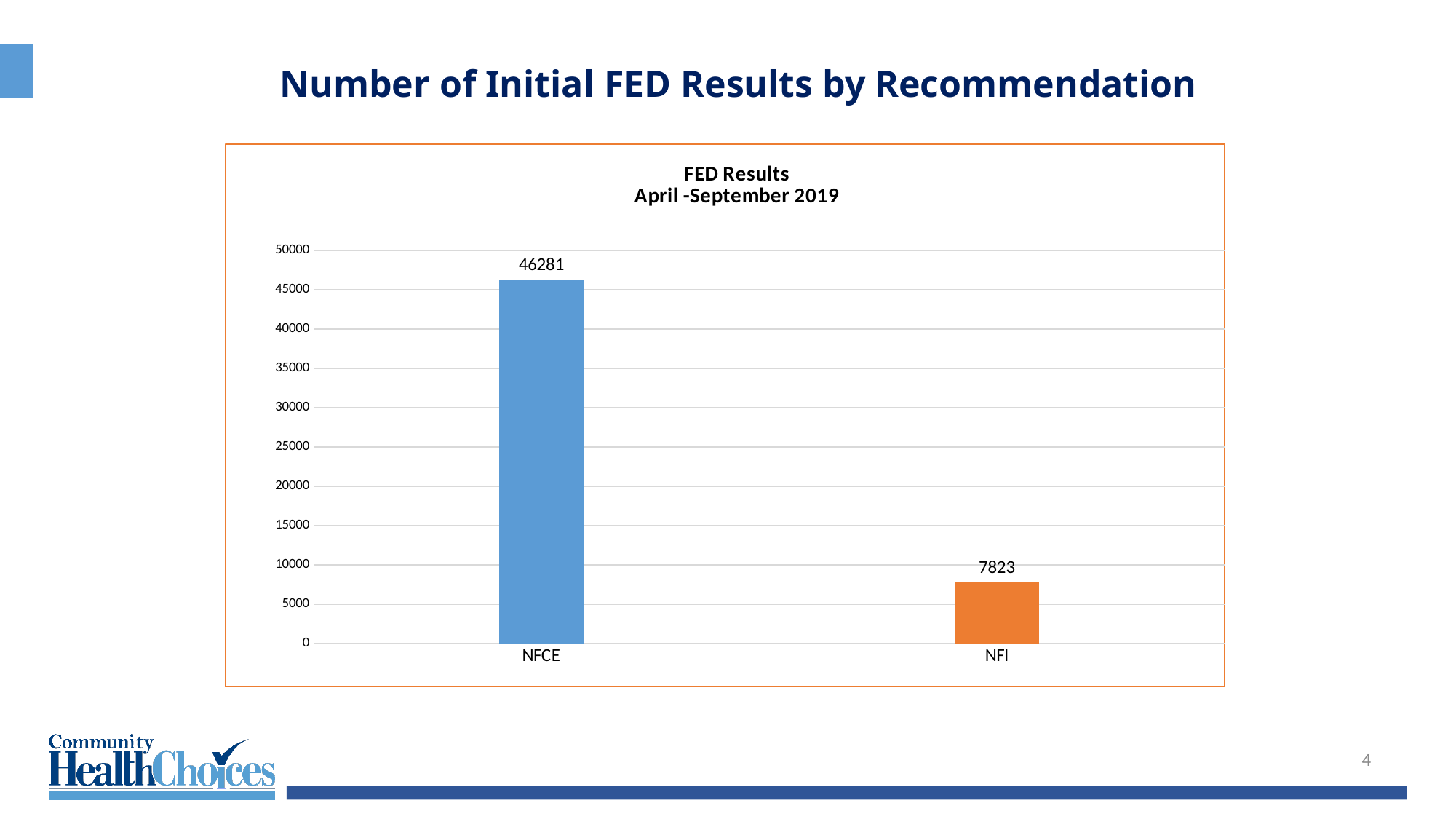
What is the total of the values for NFCE and NFI? 54104 Is the value for NFI greater or less than 10000? less What is the title of the chart? FED Results April -September 2019 What kind of chart is shown on the slide? bar chart What is the value for NFI? 7823 Which category has the lowest value? NFI Is the value for NFCE greater or less than 45000? greater How many categories are shown on the chart? 2 What is the difference between the values for NFCE and NFI? 38458 What is the value for NFCE? 46281 Which is larger, the value for NFCE or the value for NFI? NFCE Which category has the highest value? NFCE